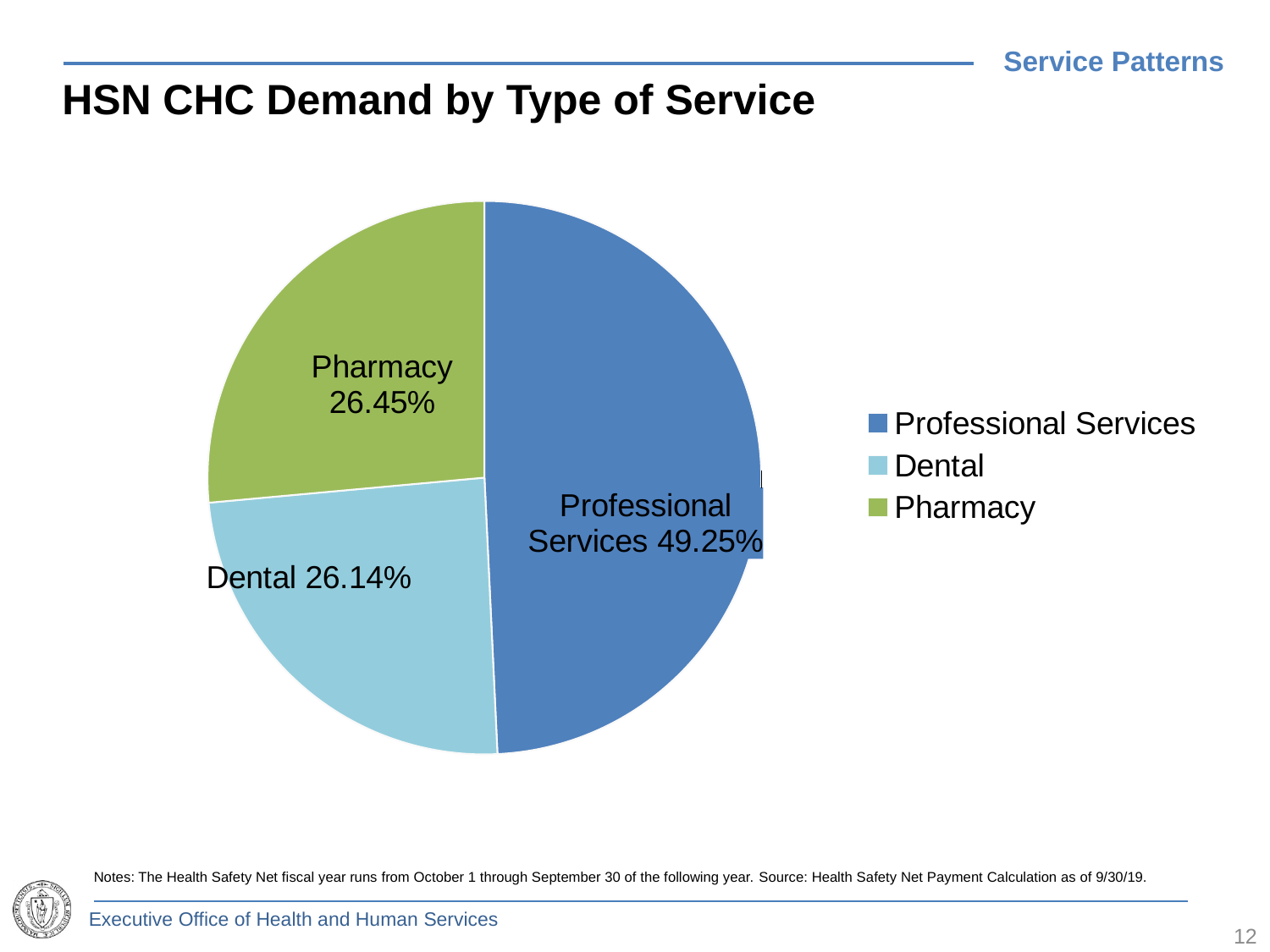
What share of HSN CHC demand is Dental? 26.14% How many slices does the pie chart have? 3 What share of HSN CHC demand is Pharmacy? 26.45% What is the difference in percentage points between the Pharmacy share and the Dental share? 0.31 How many entries does the legend list? 3 What is the difference in percentage points between the Professional Services share and the Dental share? 23.11 What is the title of the chart? HSN CHC Demand by Type of Service Is the share for Professional Services greater or less than the share for Pharmacy? greater What share of HSN CHC demand is Professional Services? 49.25% Which type of service has the largest share of HSN CHC demand? Professional Services What type of chart is shown on the slide? pie chart Which type of service has the smallest share of HSN CHC demand? Dental